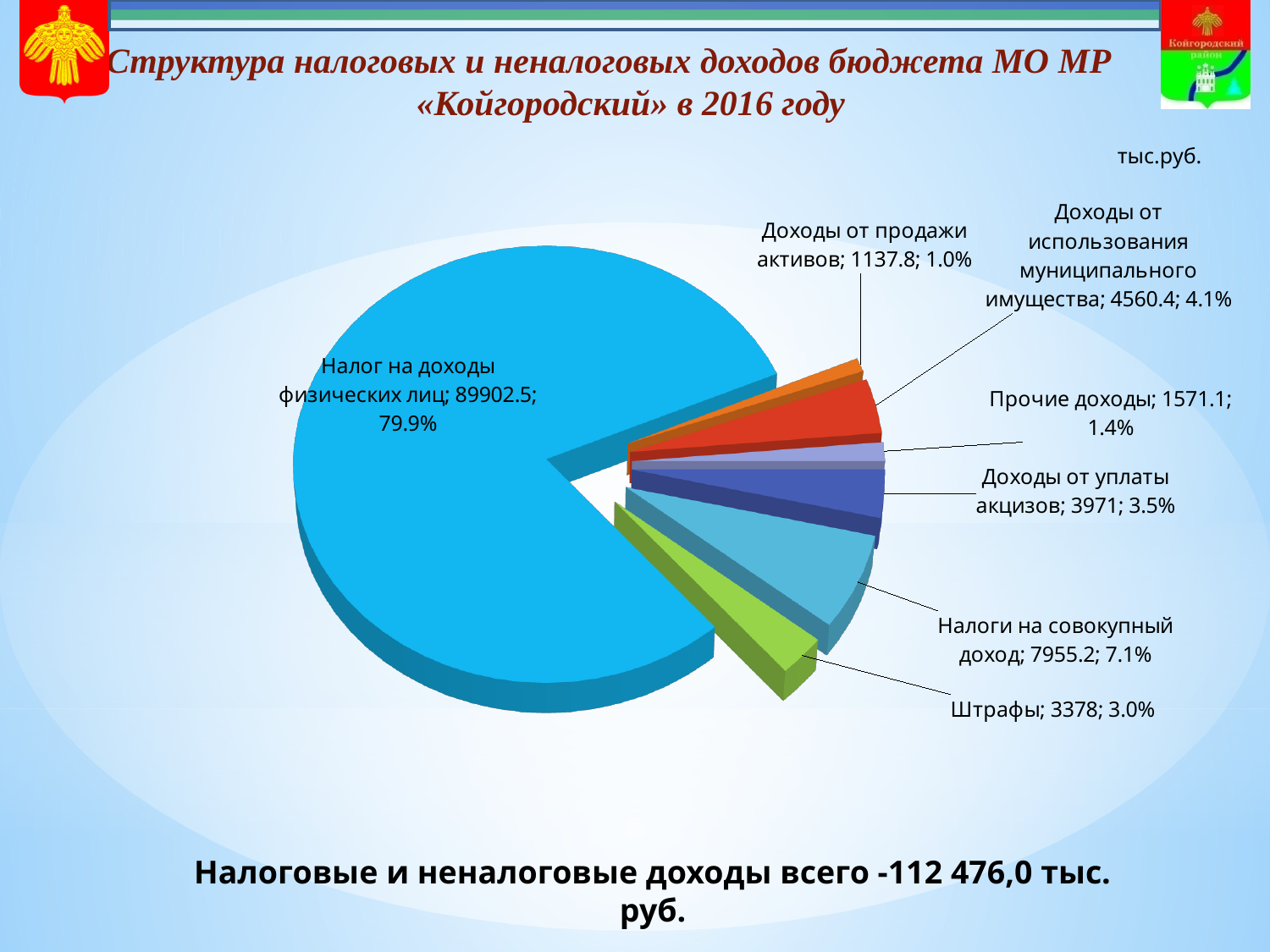
What unit of measurement is indicated for the chart values? тыс.руб. Which is larger: «Доходы от уплаты акцизов» or «Прочие доходы»? Доходы от уплаты акцизов What share of the pie does «Доходы от использования муниципального имущества» represent? 4.1% What is the value for «Налоги на совокупный доход»? 7955.2 What kind of chart is shown on the slide? Pie chart What is the value for «Налог на доходы физических лиц»? 89902.5 What is the difference between the values for «Налоги на совокупный доход» and «Доходы от уплаты акцизов»? 3984.2 What is the value for «Штрафы»? 3378 Which category has the largest slice of the pie? Налог на доходы физических лиц What share of the pie does «Налог на доходы физических лиц» represent? 79.9% How many slices does the pie chart have? 7 Which category has the smallest slice of the pie? Доходы от продажи активов